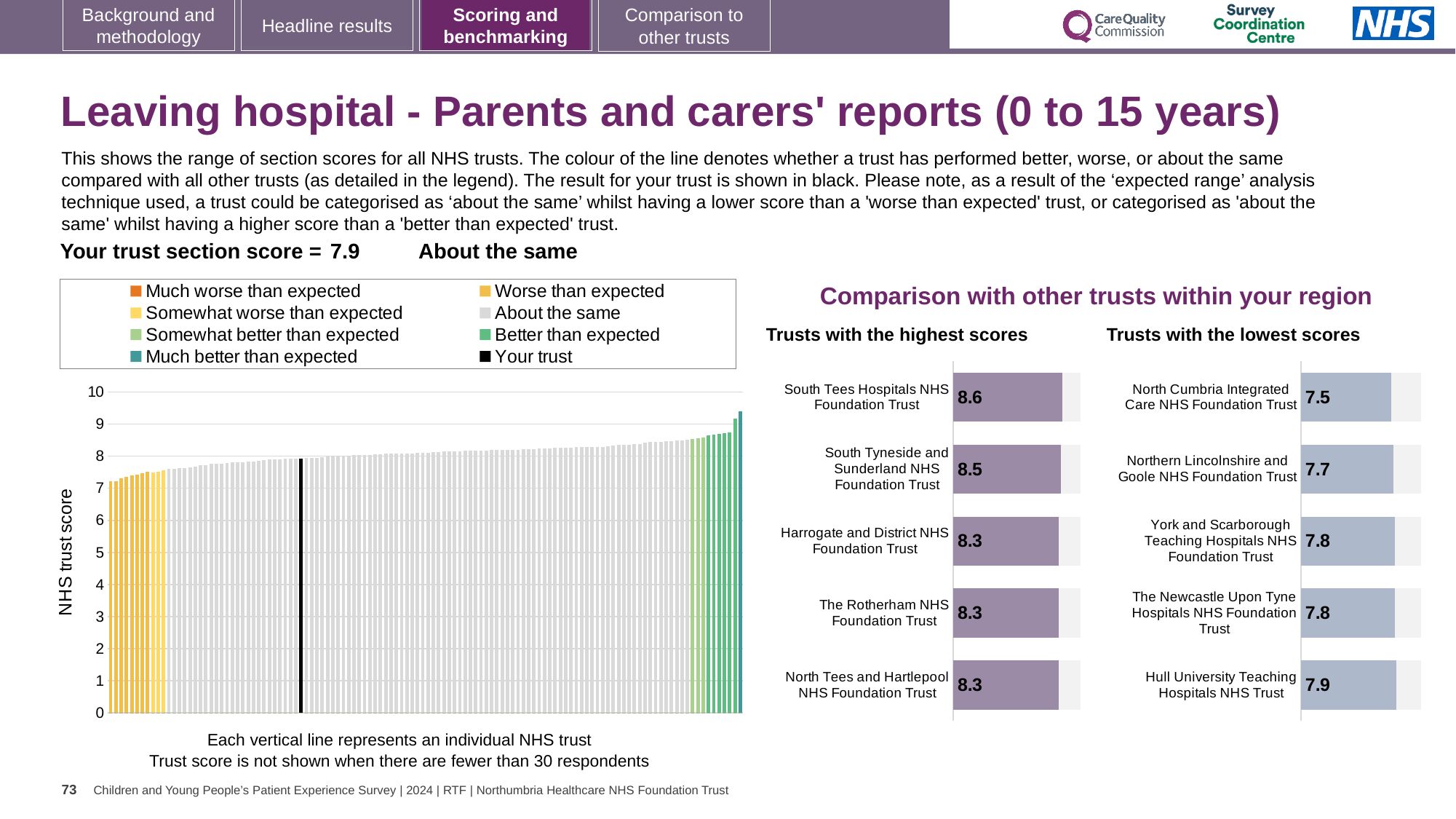
How many trusts are listed in the 'Trusts with the highest scores' chart? 5 What kind of chart is the large chart on the left showing NHS trust scores? Bar chart In the 'Trusts with the lowest scores' chart, what is the difference between the scores of Hull University Teaching Hospitals NHS Trust and North Cumbria Integrated Care NHS Foundation Trust? 0.4 In the 'Trusts with the lowest scores' chart, which has the larger score: Northern Lincolnshire and Goole NHS Foundation Trust or York and Scarborough Teaching Hospitals NHS Foundation Trust? York and Scarborough Teaching Hospitals NHS Foundation Trust In the 'Trusts with the lowest scores' chart, what is the score for Hull University Teaching Hospitals NHS Trust? 7.9 In the large chart on the left showing NHS trust scores, is the value for 'Your trust' (the black line) greater or less than 5? greater In the 'Trusts with the highest scores' chart, which trust has the highest score? South Tees Hospitals NHS Foundation Trust In the 'Trusts with the lowest scores' chart, what is the score for North Cumbria Integrated Care NHS Foundation Trust? 7.5 In the 'Trusts with the highest scores' chart, what is the difference between the scores of South Tees Hospitals NHS Foundation Trust and Harrogate and District NHS Foundation Trust? 0.3 In the 'Trusts with the highest scores' chart, what is the score for South Tyneside and Sunderland NHS Foundation Trust? 8.5 In the 'Trusts with the highest scores' chart, what is the score for South Tees Hospitals NHS Foundation Trust? 8.6 In the 'Trusts with the lowest scores' chart, which trust has the lowest score? North Cumbria Integrated Care NHS Foundation Trust